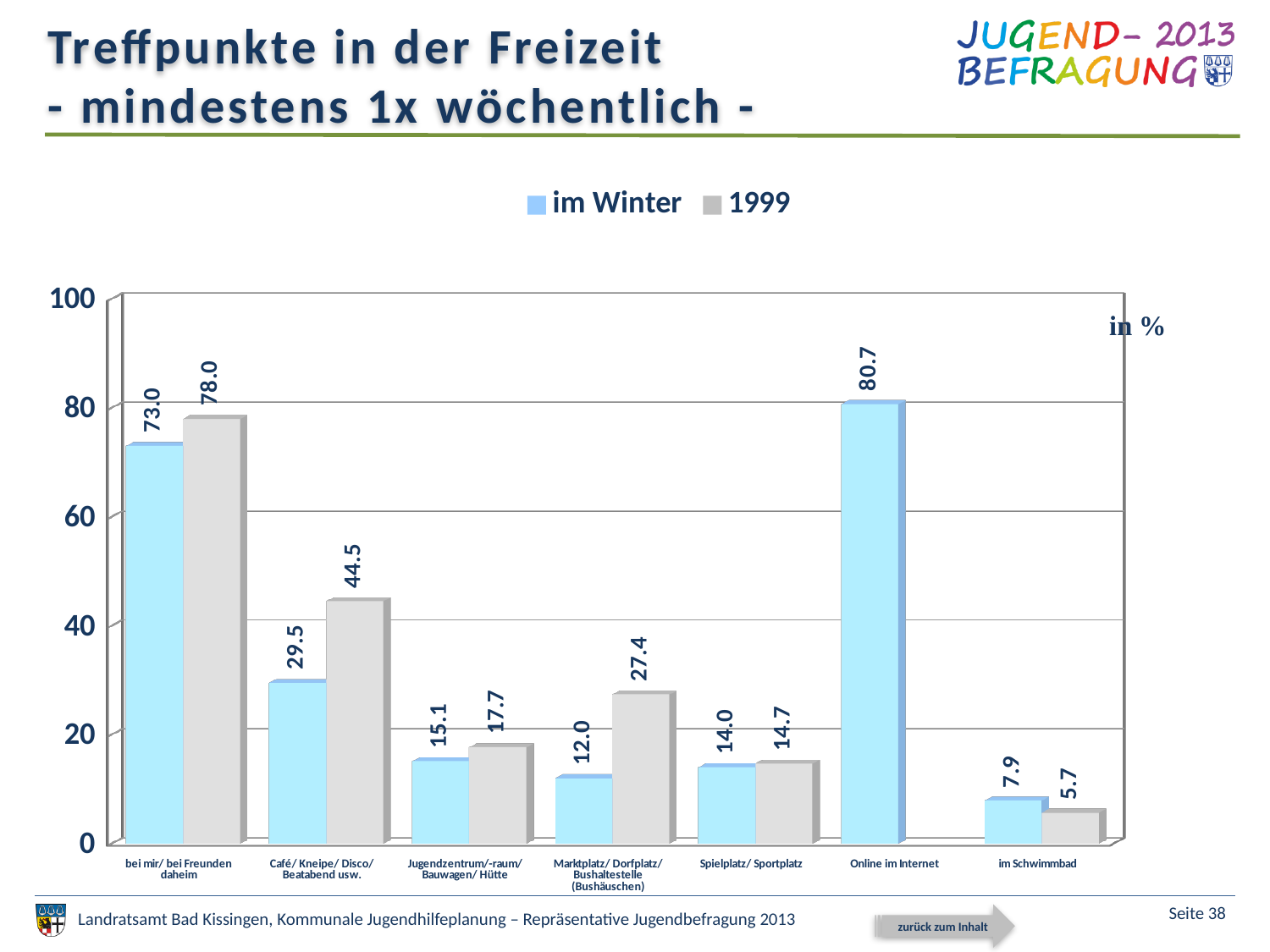
Which series is shown in grey according to the legend? 1999 What is the "im Winter" value for "Marktplatz/ Dorfplatz/ Bushaltestelle (Bushäuschen)"? 12.0 What is the difference between the 1999 value and the "im Winter" value for "bei mir/ bei Freunden daheim"? 5.0 How many categories are shown on the x axis? 7 Is the "im Winter" value for "Café/ Kneipe/ Disco/ Beatabend usw." greater or less than 40? less What is the 1999 value for "Café/ Kneipe/ Disco/ Beatabend usw."? 44.5 How many series does the legend list? 2 Which category has the lowest 1999 value? im Schwimmbad For "Jugendzentrum/-raum/ Bauwagen/ Hütte", which series has the larger value, "im Winter" or 1999? 1999 What kind of chart is shown on the slide? bar chart Which category has the highest "im Winter" value? Online im Internet What is the value for "im Winter" for "Online im Internet"? 80.7